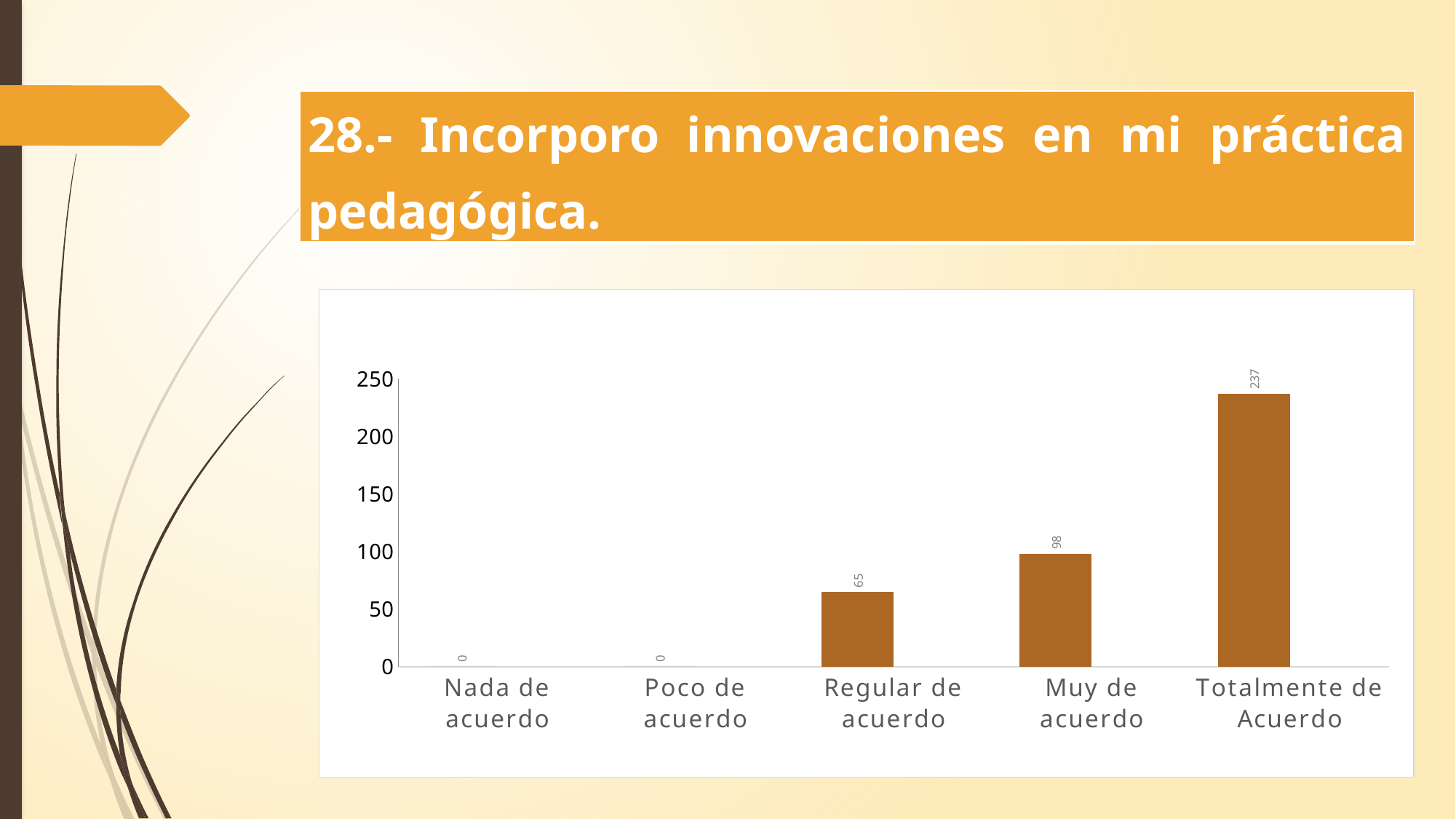
Which is larger, the value for "Regular de acuerdo" or the value for "Muy de acuerdo"? Muy de acuerdo What is the value for "Regular de acuerdo"? 65 What is the value for "Muy de acuerdo"? 98 What is the difference between the values for "Muy de acuerdo" and "Regular de acuerdo"? 33 What is the value for "Nada de acuerdo"? 0 How many categories are shown on the x axis? 5 Is the value for "Totalmente de Acuerdo" greater or less than 200? greater Do the values rise or fall from left to right along the x axis? Rise What kind of chart is shown on the slide? Bar chart What is the difference between the values for "Totalmente de Acuerdo" and "Muy de acuerdo"? 139 Which category has the highest value? Totalmente de Acuerdo What is the value for "Totalmente de Acuerdo"? 237